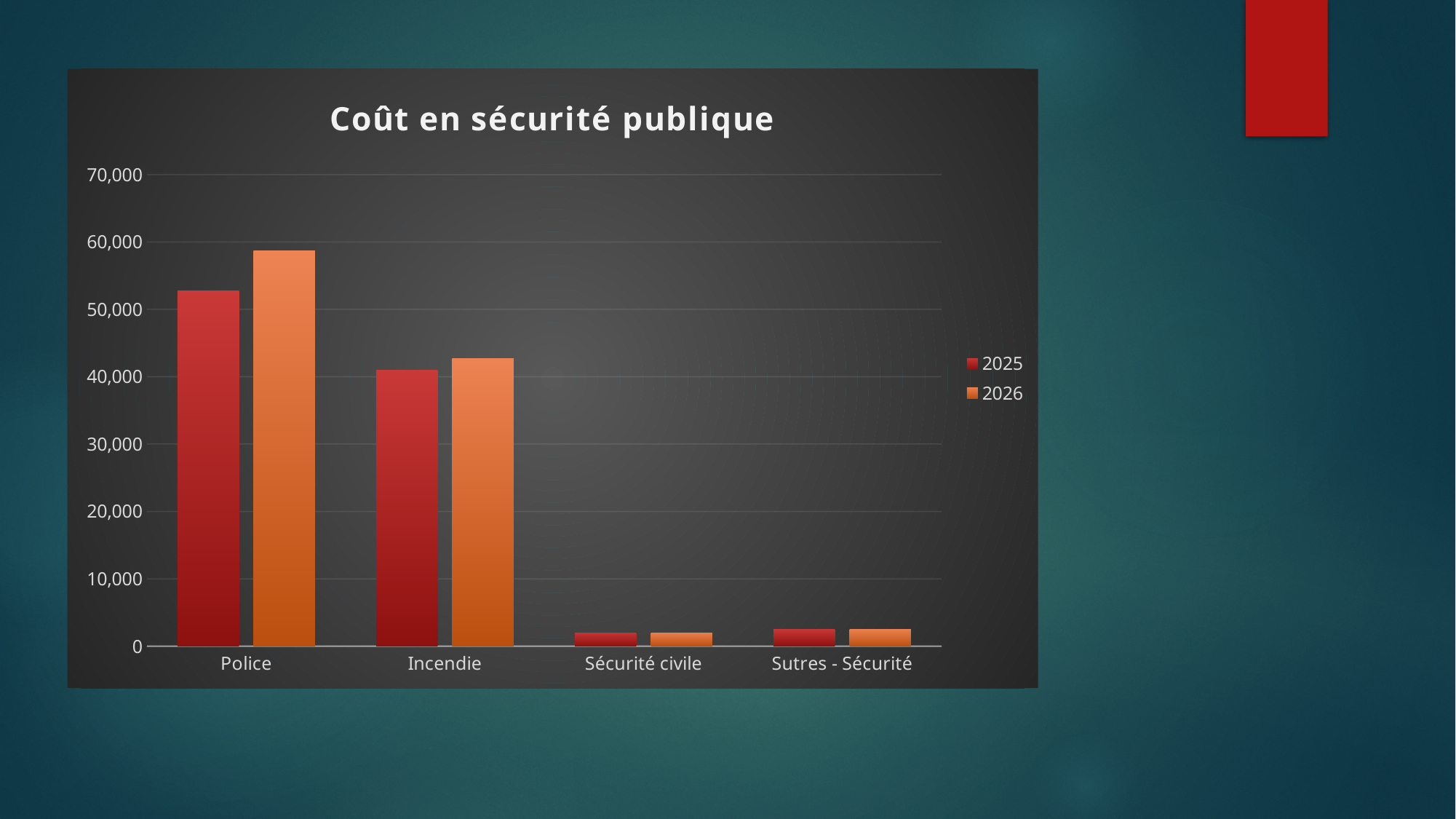
How many series does the legend list? 2 What is the title of the chart? Coût en sécurité publique What kind of chart is shown on the slide? bar chart Which category has the highest value for 2026? Police Is the value for Incendie in 2025 greater or less than 50,000? less Which is larger, the 2025 value for Police or the 2026 value for Incendie? 2025 value for Police Which category has the lowest value for 2025? Sécurité civile Is the value for Police in 2026 greater or less than 50,000? greater Which category has the highest value for 2025? Police For Police, which series is larger, 2025 or 2026? 2026 Is the value for Sécurité civile in 2026 greater or less than 10,000? less How many categories are shown on the x axis? 4